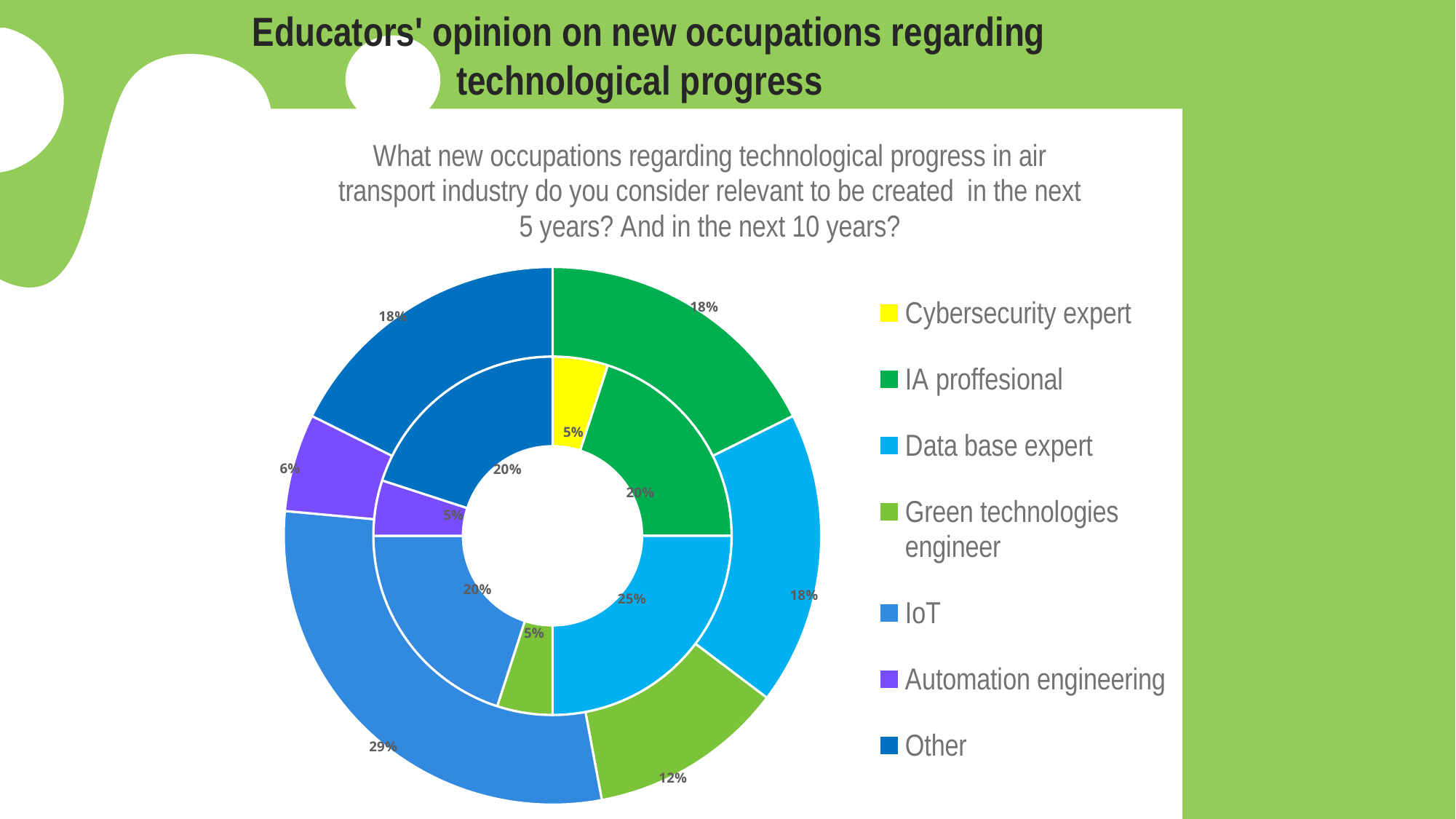
What colour represents Cybersecurity expert in the chart? Yellow What is the value for IoT in the outer ring? 29% Which category has the largest share in the inner ring? Data base expert What is the value for Data base expert in the inner ring? 25% What kind of chart is shown on the slide? Doughnut chart What is the value for Automation engineering in the outer ring? 6% In the inner ring, which is larger: IA proffesional or Cybersecurity expert? IA proffesional What is the value for Other in the inner ring? 20% In the outer ring, what is the difference between the IoT value and the Green technologies engineer value? 17 percentage points How many categories does the chart's legend list? 7 Which category has the largest share in the outer ring? IoT In the inner ring, what is the difference between the Data base expert value and the Green technologies engineer value? 20 percentage points